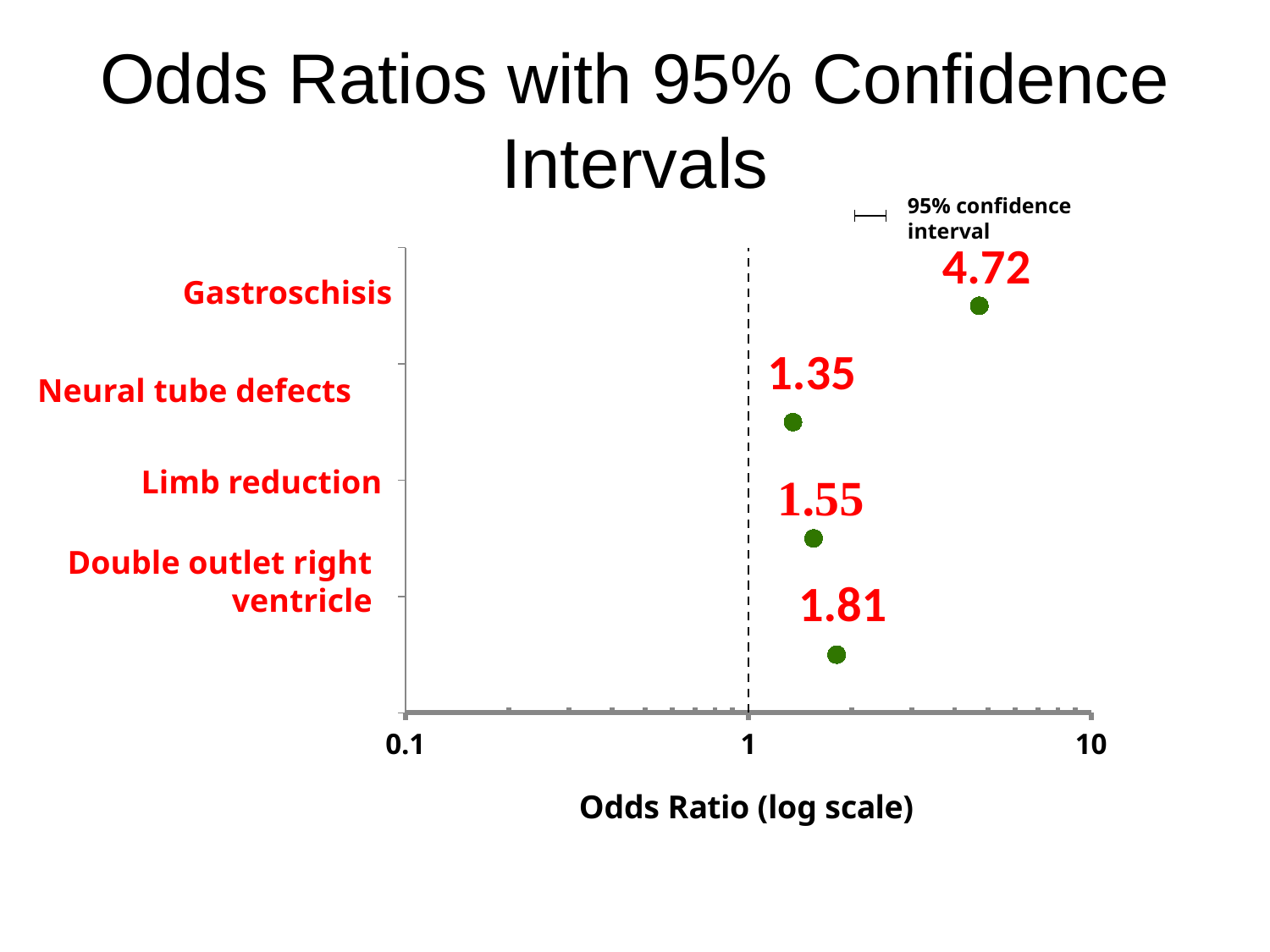
What is the odds ratio shown for Double outlet right ventricle? 1.81 Is the odds ratio for Gastroschisis greater or less than 1? greater What is the title of the chart? Odds Ratios with 95% Confidence Intervals What is the odds ratio shown for Neural tube defects? 1.35 Which category has the lowest odds ratio? Neural tube defects How many categories are plotted on the chart? 4 Which category has the highest odds ratio? Gastroschisis What is the odds ratio shown for Gastroschisis? 4.72 What is the label of the horizontal axis? Odds Ratio (log scale) Which has a larger odds ratio, Limb reduction or Double outlet right ventricle? Double outlet right ventricle What is the odds ratio shown for Limb reduction? 1.55 What is the difference between the odds ratios for Gastroschisis and Double outlet right ventricle? 2.91